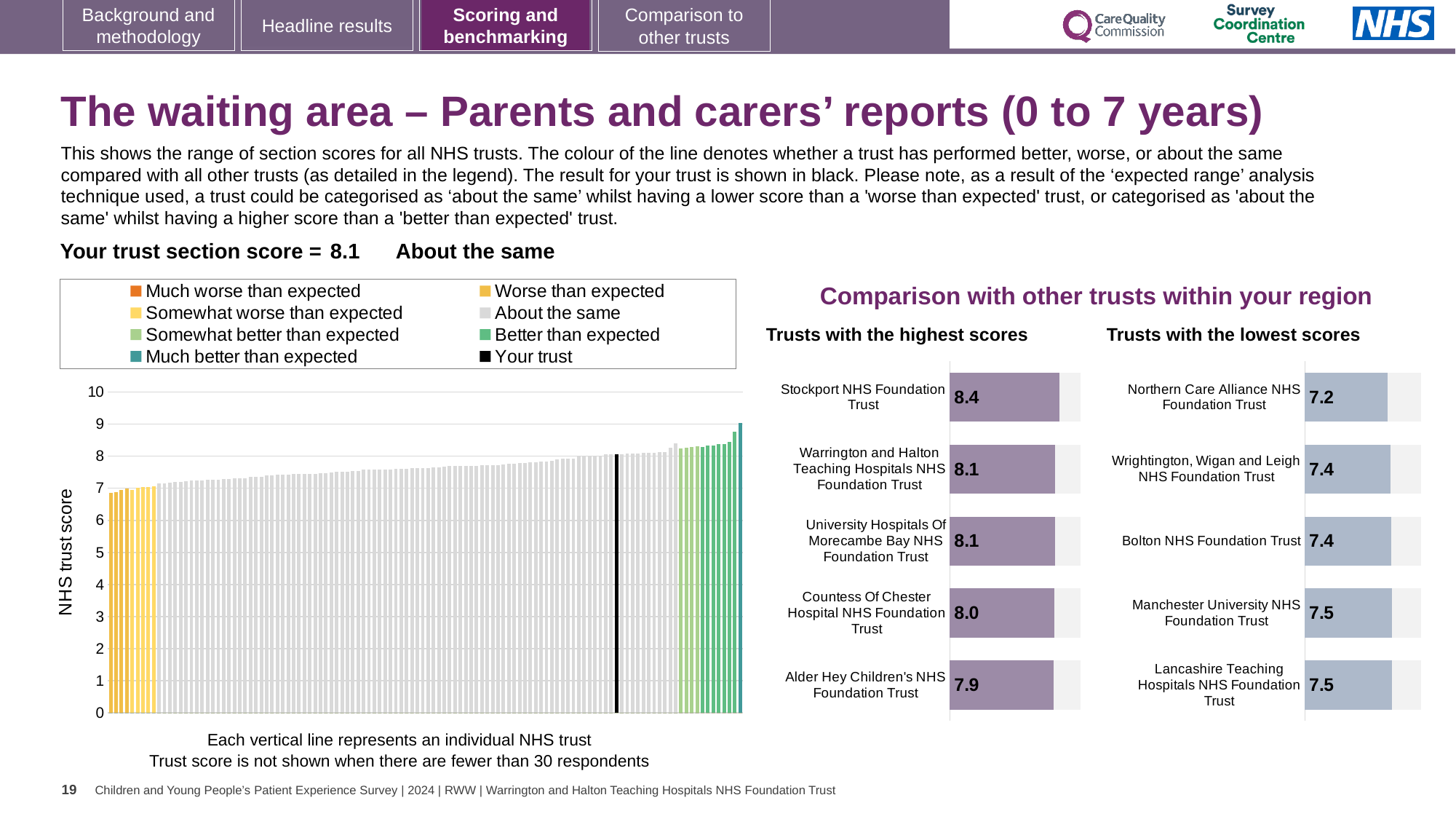
In the 'Trusts with the highest scores' chart, what is the score for Stockport NHS Foundation Trust? 8.4 In the 'Trusts with the highest scores' chart, which trust has the highest score? Stockport NHS Foundation Trust In the 'Trusts with the highest scores' chart, what is the score for Alder Hey Children's NHS Foundation Trust? 7.9 In the left-hand chart of all NHS trusts, do the trust scores rise or fall from left to right? rise In the 'Trusts with the lowest scores' chart, which is larger: the score for Manchester University NHS Foundation Trust or Northern Care Alliance NHS Foundation Trust? Manchester University NHS Foundation Trust In the 'Trusts with the lowest scores' chart, what is the score for Bolton NHS Foundation Trust? 7.4 In the 'Trusts with the highest scores' chart, how many trusts are listed? 5 In the 'Trusts with the lowest scores' chart, what is the score for Northern Care Alliance NHS Foundation Trust? 7.2 In the left-hand chart of all NHS trusts, how many entries does the legend list? 8 In the 'Trusts with the highest scores' chart, what is the difference between the scores of Stockport NHS Foundation Trust and Countess Of Chester Hospital NHS Foundation Trust? 0.4 In the 'Trusts with the lowest scores' chart, what is the difference between the scores of Lancashire Teaching Hospitals NHS Foundation Trust and Northern Care Alliance NHS Foundation Trust? 0.3 In the 'Trusts with the lowest scores' chart, which trust has the lowest score? Northern Care Alliance NHS Foundation Trust